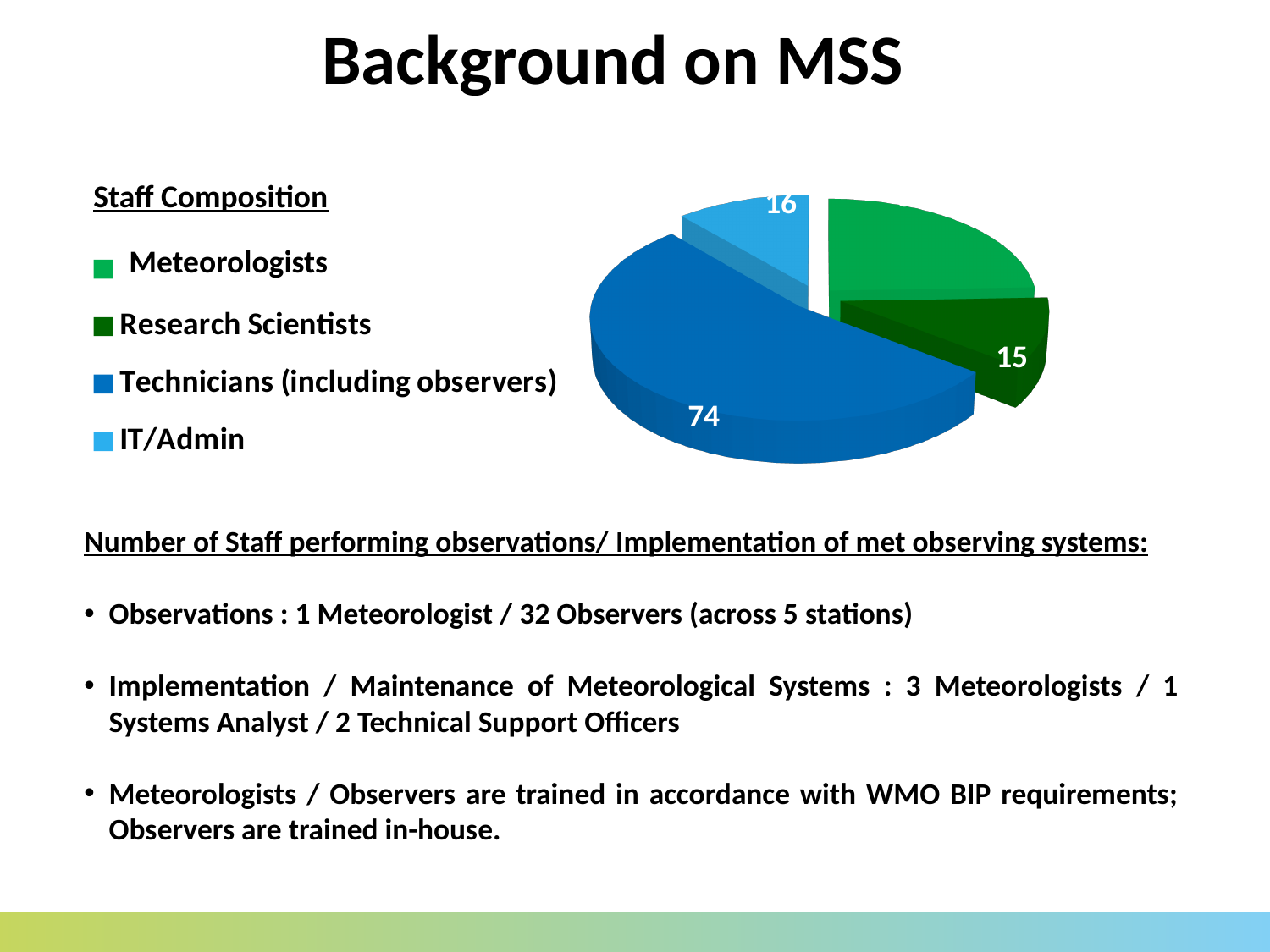
Which staff category has the largest slice in the pie chart? Technicians (including observers) What is the difference between the Technicians (including observers) value and the Research Scientists value in the pie chart? 59 How many staff categories does the pie chart show? 4 Which is larger in the pie chart, Technicians (including observers) or IT/Admin? Technicians (including observers) Which is larger in the pie chart, Research Scientists or IT/Admin? IT/Admin What value is shown for Research Scientists in the pie chart? 15 What value is shown for Technicians (including observers) in the pie chart? 74 What type of chart is used to show the staff composition? Pie chart What value is shown for IT/Admin in the pie chart? 16 What is the difference between the Technicians (including observers) value and the IT/Admin value in the pie chart? 58 What is the difference between the IT/Admin value and the Research Scientists value in the pie chart? 1 What colour is the Technicians (including observers) slice in the pie chart? Blue